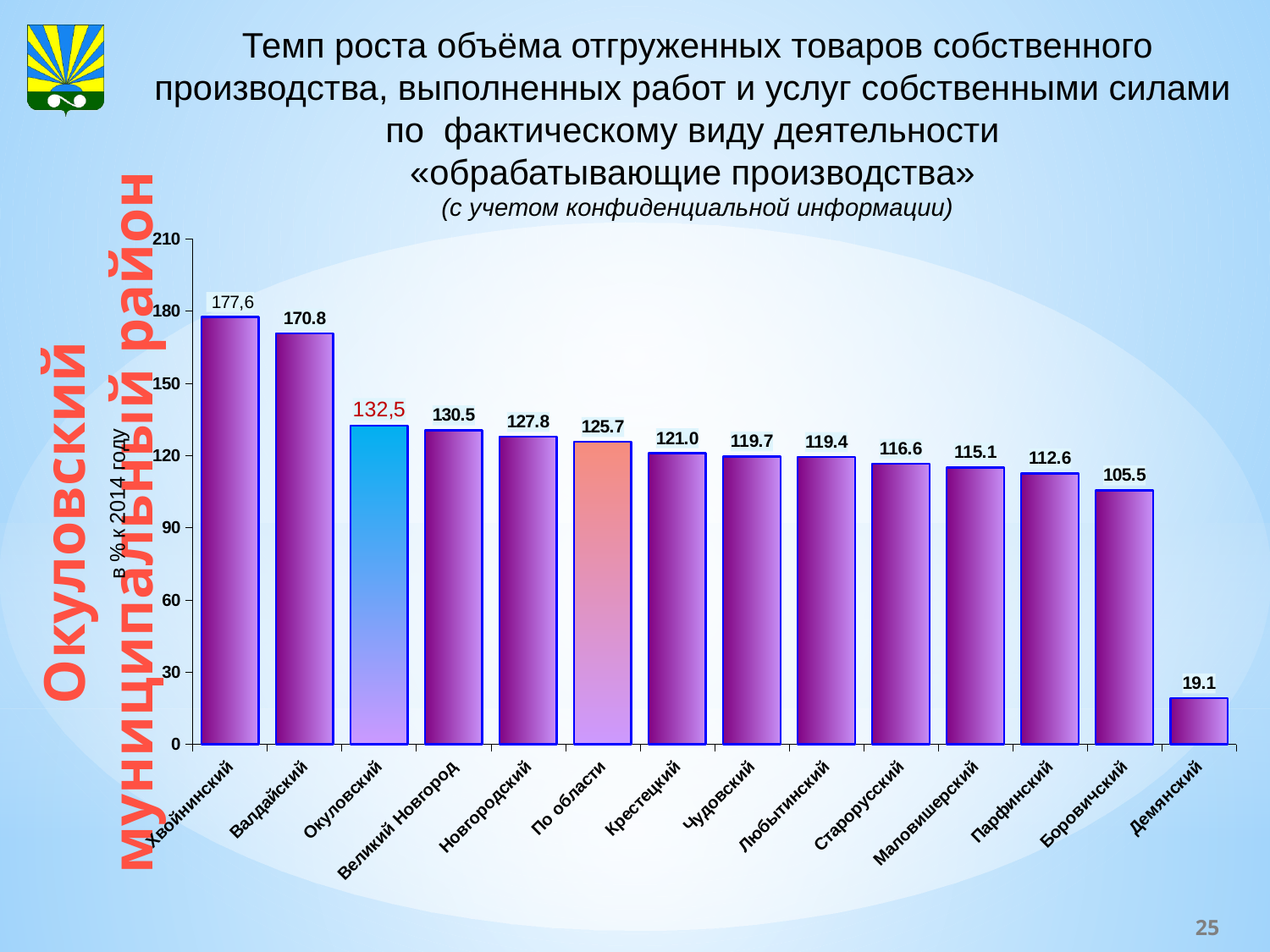
What is the value for Окуловский? 132,5 Is the value for Парфинский greater or less than 120? less Which category has the highest value? Хвойнинский What is the difference between the values for Боровичский and Демянский? 86.4 Which category has the lowest value? Демянский Which is larger, the value for Валдайский or the value for Крестецкий? Валдайский What is the value for Великий Новгород? 130.5 What kind of chart is shown on the slide? bar chart What is the difference between the values for Великий Новгород and Новгородский? 2.7 How many categories are shown on the x axis? 14 What is the value for Демянский? 19.1 What is the value for По области? 125.7